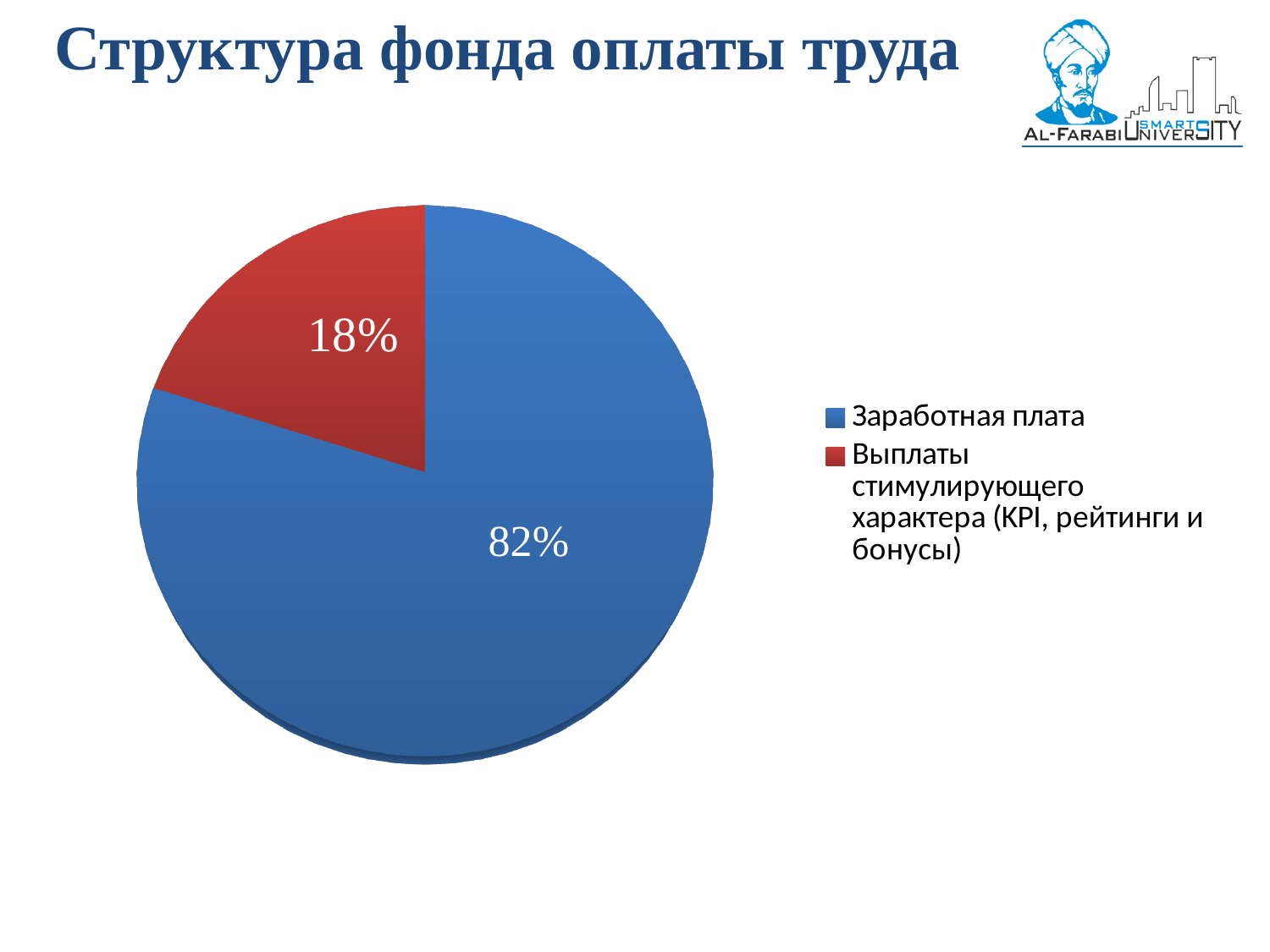
Which category has the smallest slice of the pie? Выплаты стимулирующего характера (KPI, рейтинги и бонусы) What is the difference in percentage points between the "Заработная плата" slice and the "Выплаты стимулирующего характера" slice? 64 What kind of chart is shown on the slide? pie chart Which is larger: the share for "Заработная плата" or the share for "Выплаты стимулирующего характера (KPI, рейтинги и бонусы)"? Заработная плата What colour is the slice for "Заработная плата"? blue How many slices does the pie chart have? 2 What share of the pie does "Заработная плата" take? 82% What share of the pie does "Выплаты стимулирующего характера (KPI, рейтинги и бонусы)" take? 18% Which category has the largest slice of the pie? Заработная плата What is the title of the slide containing the chart? Структура фонда оплаты труда How many entries does the legend list? 2